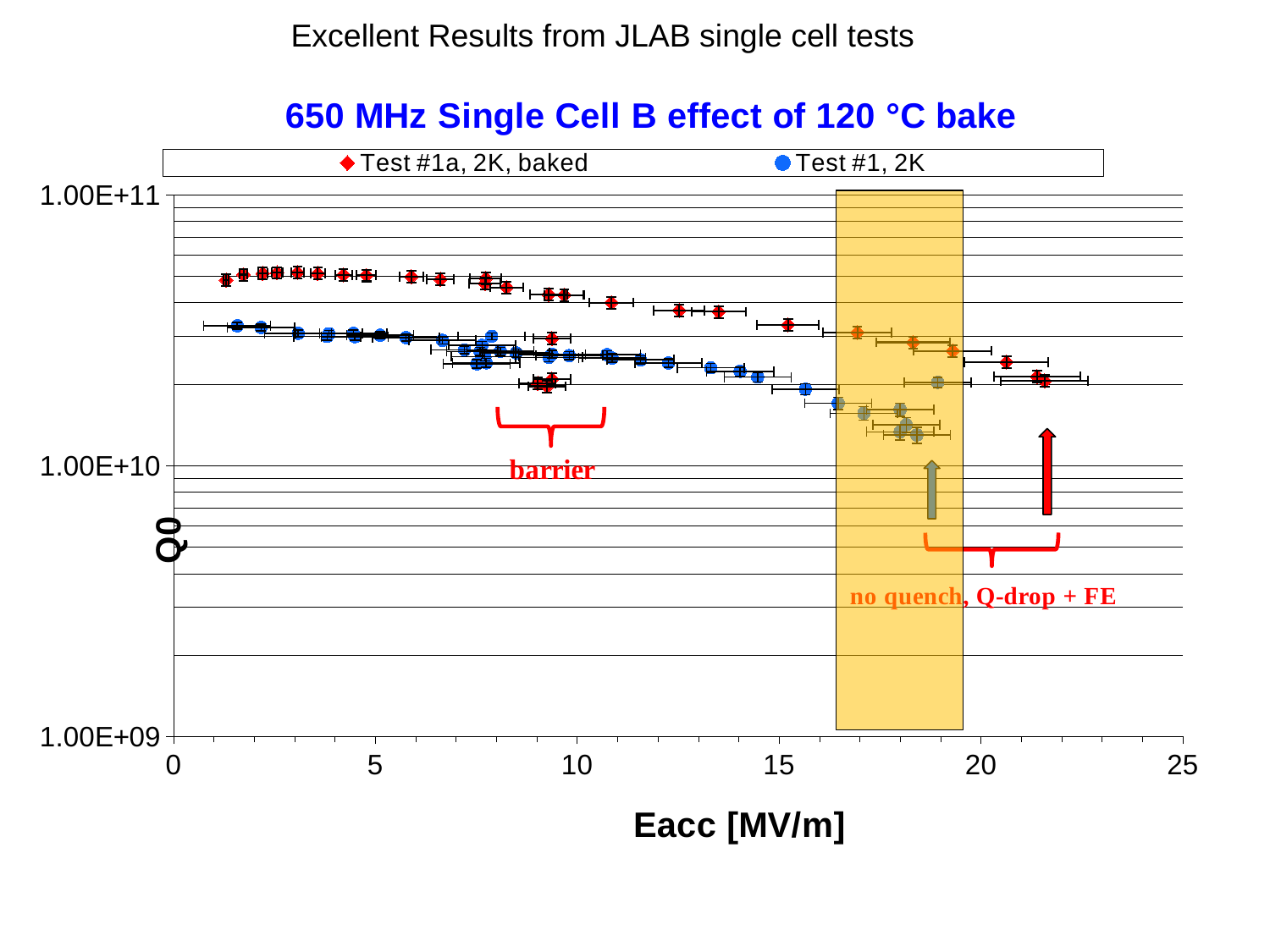
Is the Q0 value for Test #1a, 2K, baked at an Eacc of about 22 MV/m greater or less than 1.00E+10? greater Do the Q0 values for Test #1, 2K rise or fall as Eacc increases? Fall Is the Q0 value for Test #1a, 2K, baked at an Eacc of about 5 MV/m greater or less than 1.00E+10? greater Which series reaches the higher maximum Eacc, Test #1a, 2K, baked or Test #1, 2K? Test #1a, 2K, baked Do the Q0 values for Test #1a, 2K, baked rise or fall as Eacc increases? Fall What is the title of the chart? 650 MHz Single Cell B effect of 120 °C bake How many series does the chart legend list? 2 What is the label of the x axis? Eacc [MV/m] What kind of chart is shown on the slide? Scatter chart What is the lowest value shown on the y axis? 1.00E+09 Is the Q0 value for Test #1, 2K at an Eacc of about 15 MV/m greater or less than 1.00E+11? less Which series has the higher Q0 at an Eacc of about 5 MV/m, Test #1a, 2K, baked or Test #1, 2K? Test #1a, 2K, baked